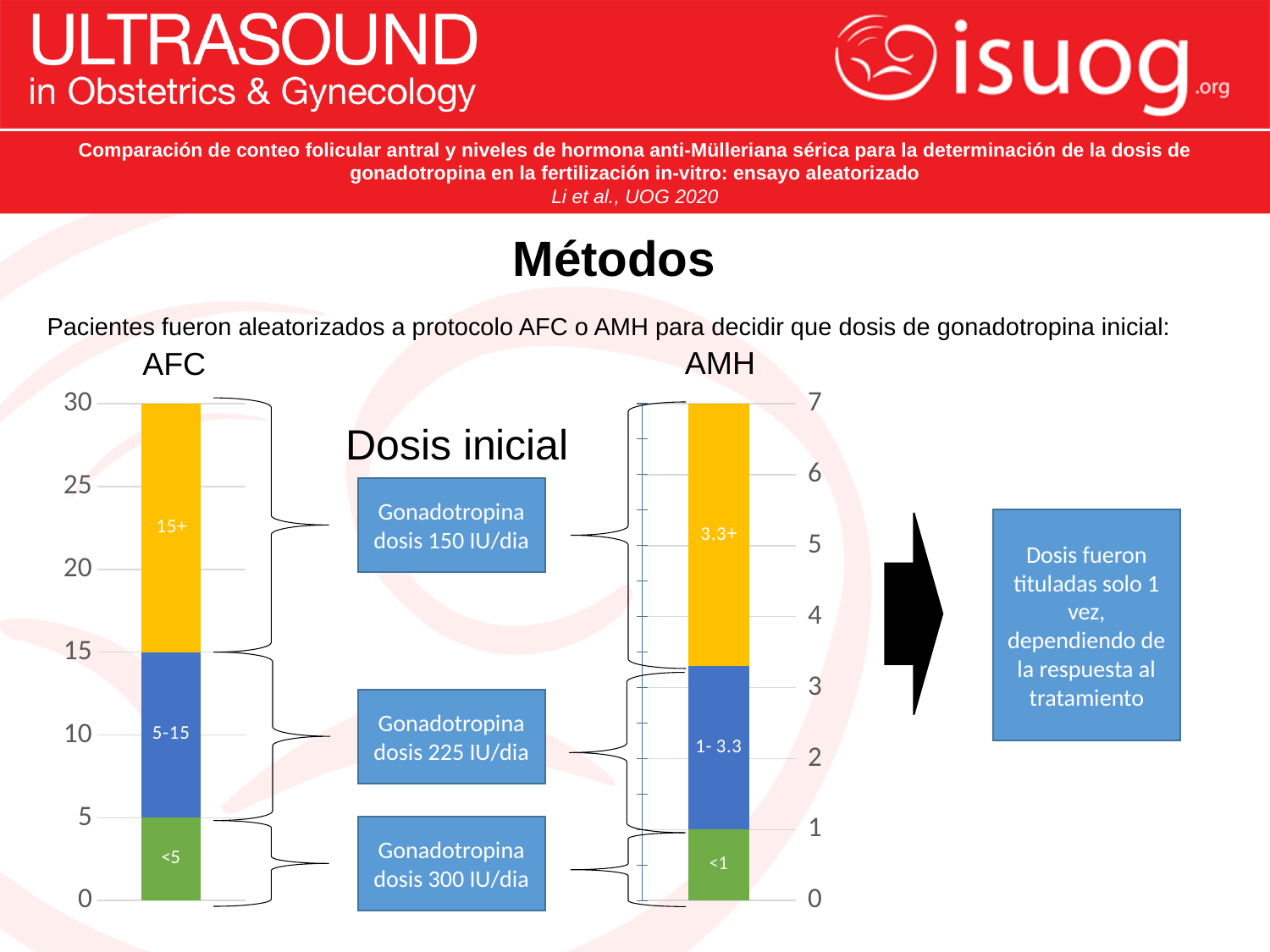
How many coloured segments does the AMH bar have? 3 What is the highest value shown on the y axis of the AFC chart? 30 In the AMH chart, what label is printed on the green (bottom) segment? <1 In the AFC chart, what label is printed on the blue (middle) segment? 5-15 What is the highest value shown on the y axis of the AMH chart? 7 Which gonadotropin dose is linked to the yellow (top) segments of both charts? 150 IU/dia In the AFC chart, what label is printed on the green (bottom) segment? <5 How many coloured segments does the AFC bar have? 3 What kind of chart is the AFC chart on the left? Stacked bar chart In the AFC chart, what label is printed on the yellow (top) segment? 15+ In the AMH chart, what label is printed on the yellow (top) segment? 3.3+ In the AMH chart, what label is printed on the blue (middle) segment? 1- 3.3